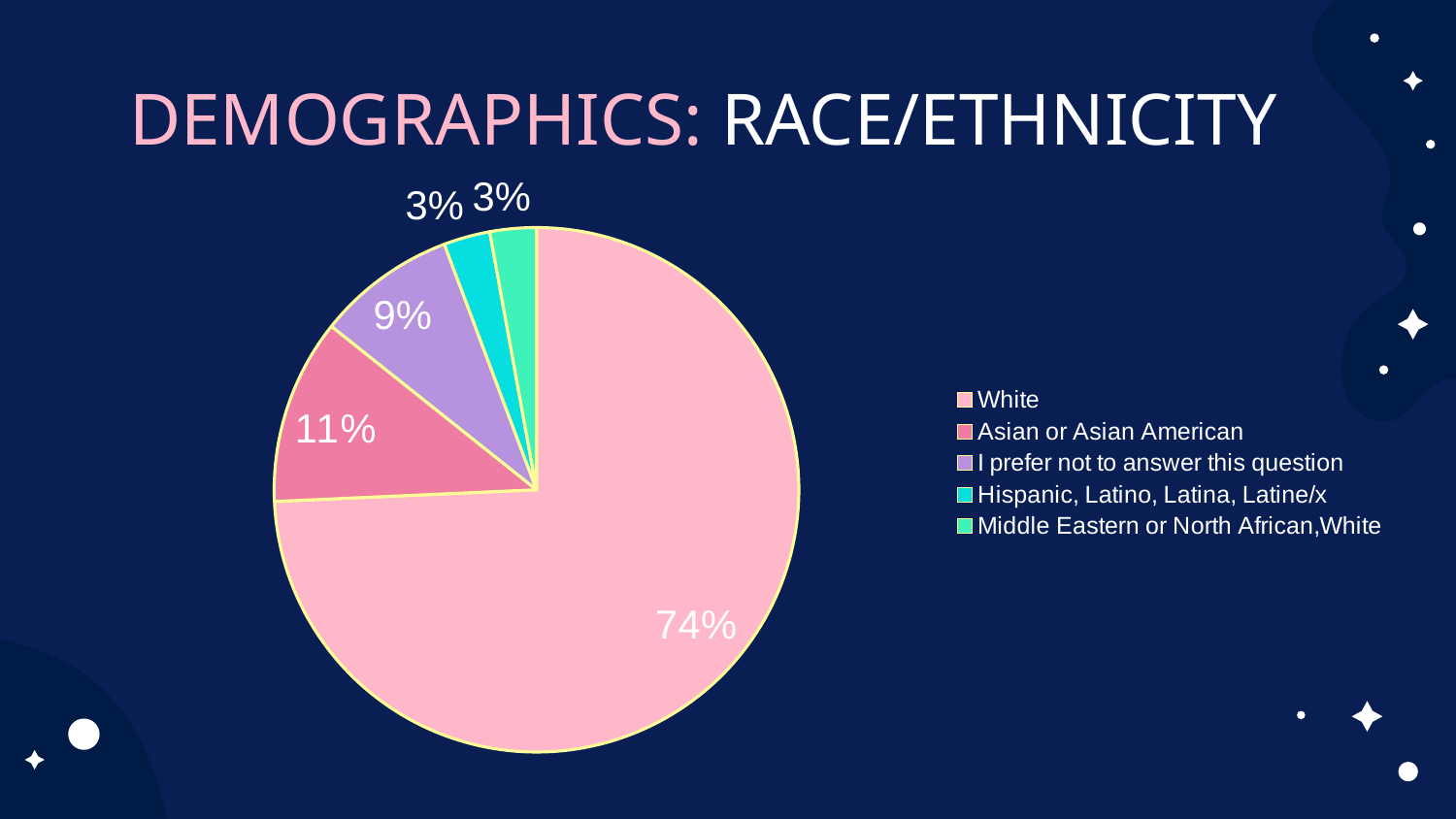
How many categories does the legend list? 5 What share of the pie does White represent? 74% What is the difference between the White share and the Asian or Asian American share? 63% What kind of chart is shown on the slide? pie chart What share of the pie does Asian or Asian American represent? 11% What share of the pie does Hispanic, Latino, Latina, Latine/x represent? 3% Which legend entry is shown in green? Middle Eastern or North African,White What is the difference between the 'I prefer not to answer this question' share and the Hispanic, Latino, Latina, Latine/x share? 6% Which is larger, the share for Asian or Asian American or the share for 'I prefer not to answer this question'? Asian or Asian American What is the title of the slide containing the chart? DEMOGRAPHICS: RACE/ETHNICITY Which category has the largest slice of the pie? White